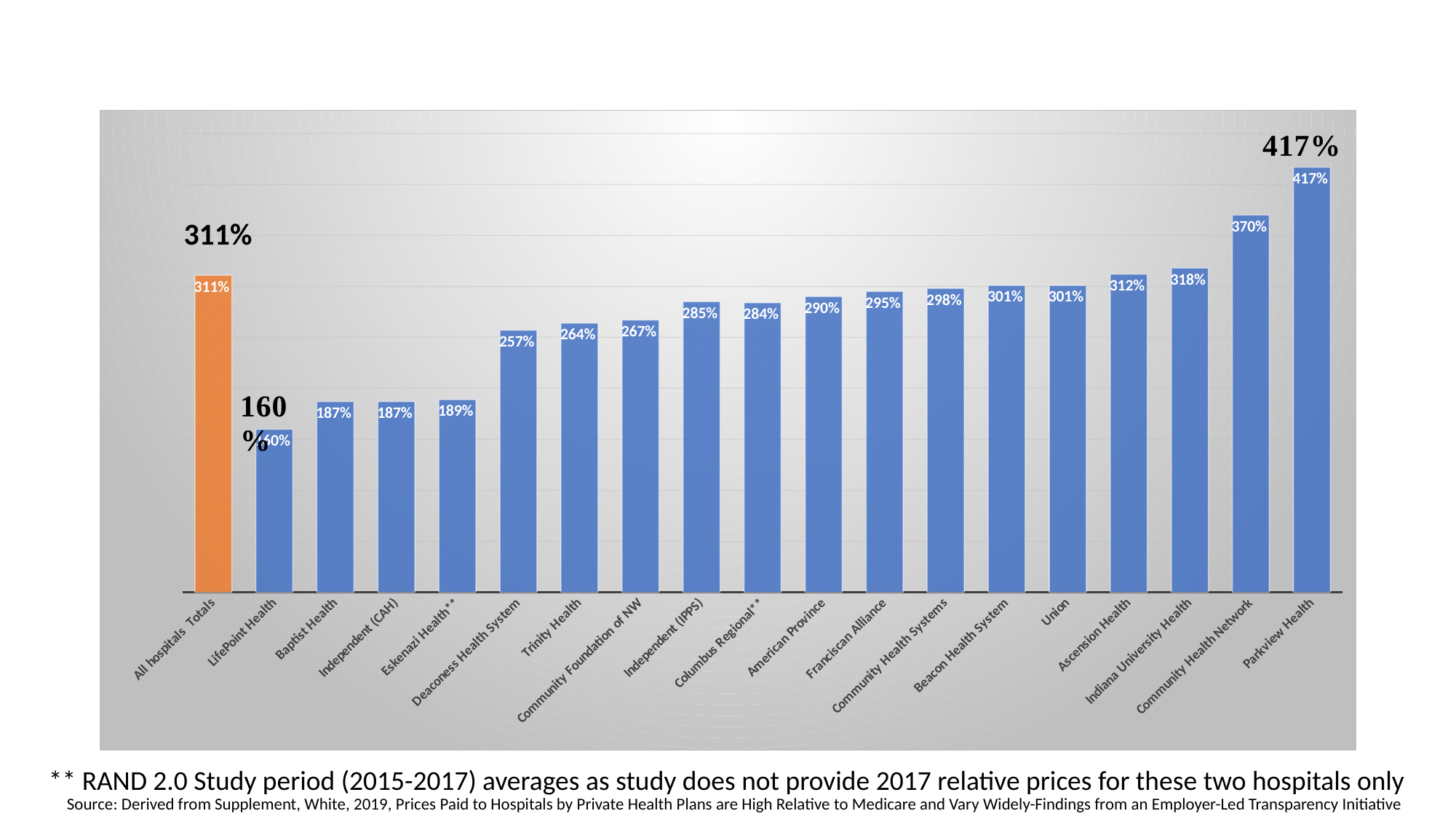
Which bar is coloured orange rather than blue? All hospitals Totals How many bars are shown in the chart? 19 What kind of chart is shown on the slide? Bar chart What is the value for All hospitals Totals? 311% What is the value for Deaconess Health System? 257% Which category has the lowest value? LifePoint Health What is the value for Parkview Health? 417% Which category has the highest value? Parkview Health What is the difference between the values for Community Health Network and All hospitals Totals? 59% Which is larger, the value for Trinity Health or the value for Ascension Health? Ascension Health What is the difference between the values for Parkview Health and LifePoint Health? 257% What is the value for Community Health Network? 370%